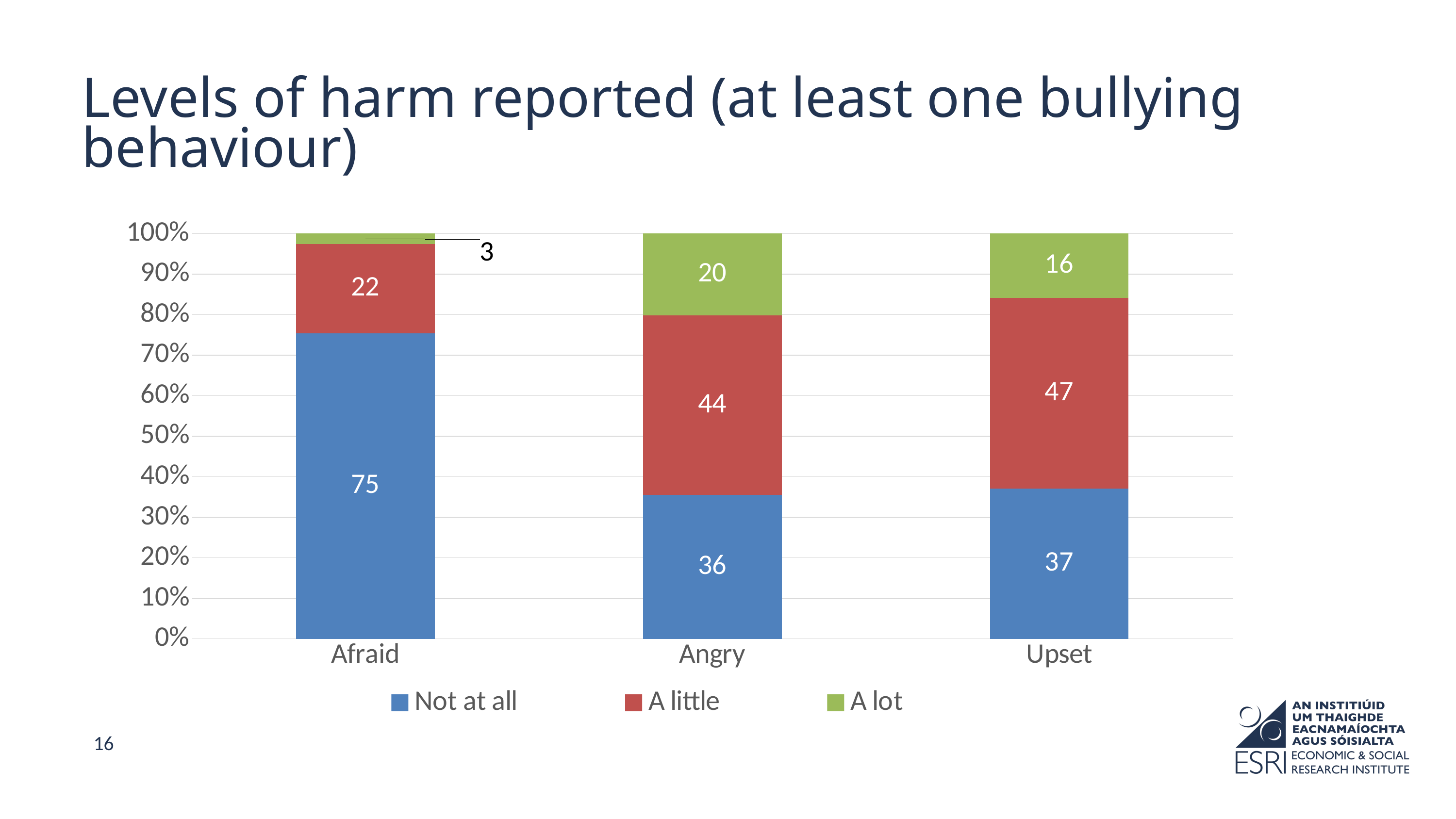
What is the value for "A little" in the Upset category? 47 What kind of chart is shown on the slide? Stacked bar chart How many series does the legend list? 3 Which category has the lowest "A lot" value? Afraid How many categories are shown on the x axis? 3 What is the value for "A lot" in the Afraid category? 3 What is the value for "Not at all" in the Afraid category? 75 What is the difference between the "A little" values for Upset and Afraid? 25 Which is larger: the "A lot" value for Angry or for Upset? Angry What is the value for "A lot" in the Angry category? 20 Which colour represents the "A little" series? Red Which category has the highest "Not at all" value? Afraid